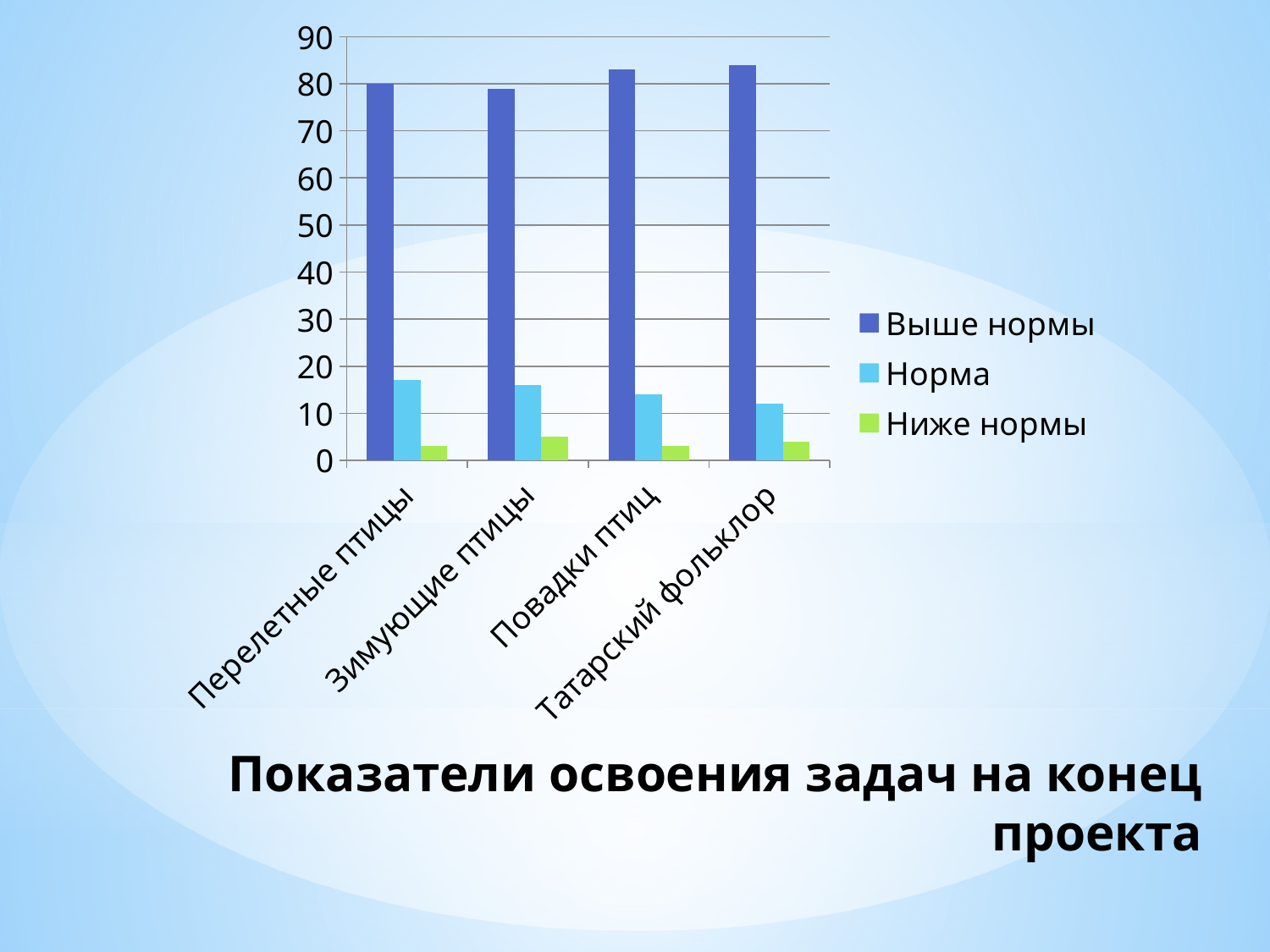
How many series does the chart's legend list? 3 Which series is shown in green in the chart's legend? Ниже нормы Is the value of Выше нормы for Татарский фольклор greater or less than 80? greater Is the value of Норма for Татарский фольклор greater or less than 20? less What kind of chart is shown on the slide? bar chart Which category has the lowest value for Норма? Татарский фольклор Is the value of Ниже нормы for Зимующие птицы greater or less than 10? less How many categories are shown on the x axis of the chart? 4 Do the values of the Норма series rise or fall from left to right along the x axis? fall What is the title of the chart? Показатели освоения задач на конец проекта For Повадки птиц, which is larger: Выше нормы or Норма? Выше нормы